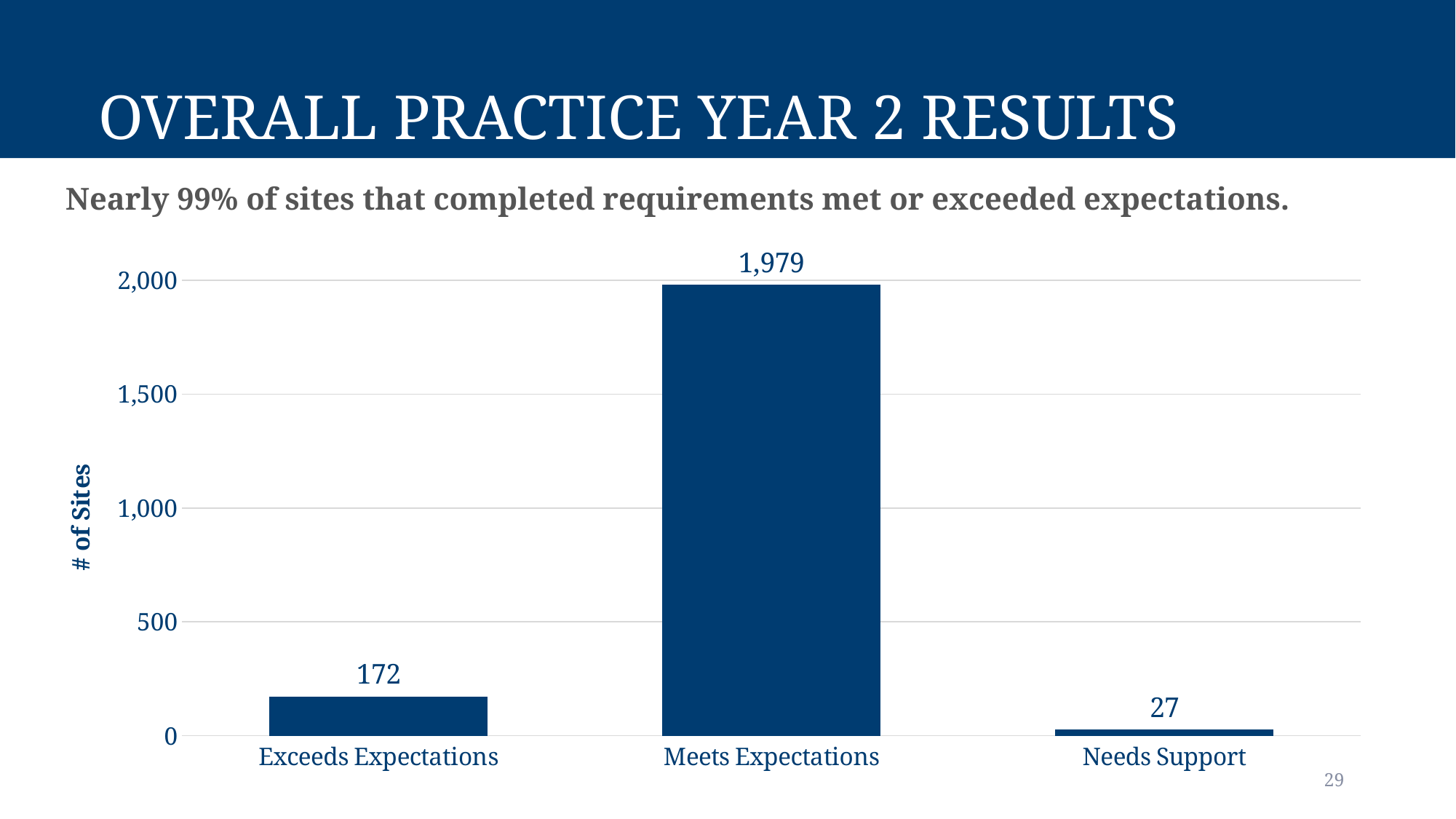
What is the label of the vertical axis? # of Sites How many sites are in the Meets Expectations category? 1,979 How many sites are in the Exceeds Expectations category? 172 Which category has the lowest number of sites? Needs Support How many categories are shown on the x axis? 3 What is the difference in the number of sites between Meets Expectations and Exceeds Expectations? 1,807 What is the difference in the number of sites between Exceeds Expectations and Needs Support? 145 What kind of chart is shown on the slide? Bar chart Is the value for Meets Expectations greater or less than 1,500? greater Which category has the highest number of sites? Meets Expectations How many sites are in the Needs Support category? 27 Which has more sites, Exceeds Expectations or Needs Support? Exceeds Expectations